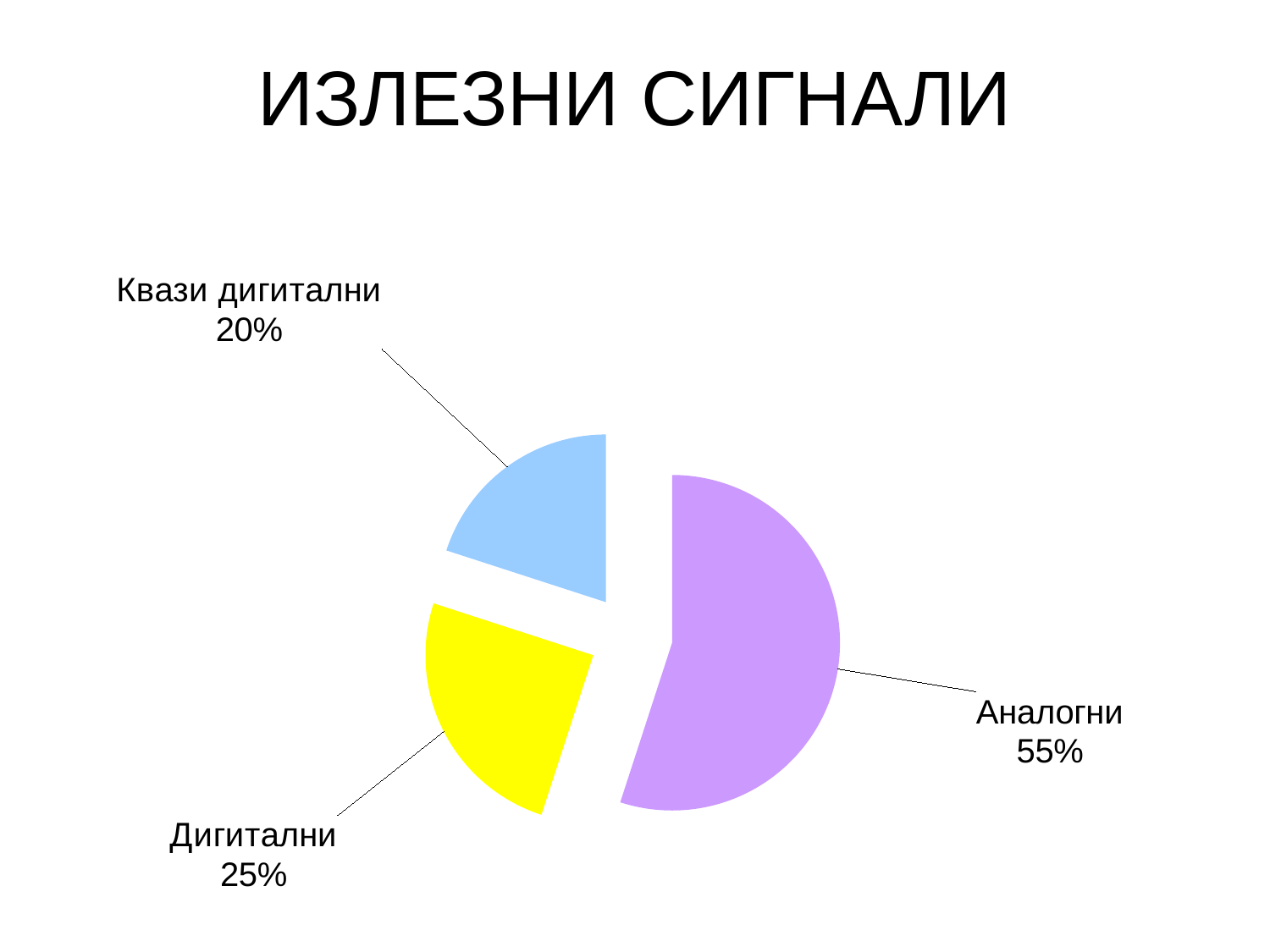
What is the share for Аналогни? 55% What is the difference in percentage points between Аналогни and Дигитални? 30 What is the title of the slide? ИЗЛЕЗНИ СИГНАЛИ Which is larger, the share for Дигитални or the share for Квази дигитални? Дигитални What kind of chart is shown on the slide? pie chart How many slices does the pie chart have? 3 What is the share for Квази дигитални? 20% Which category has the smallest slice? Квази дигитални What colour is the slice for Аналогни? purple Which category has the largest slice? Аналогни What is the difference in percentage points between Дигитални and Квази дигитални? 5 What is the share for Дигитални? 25%